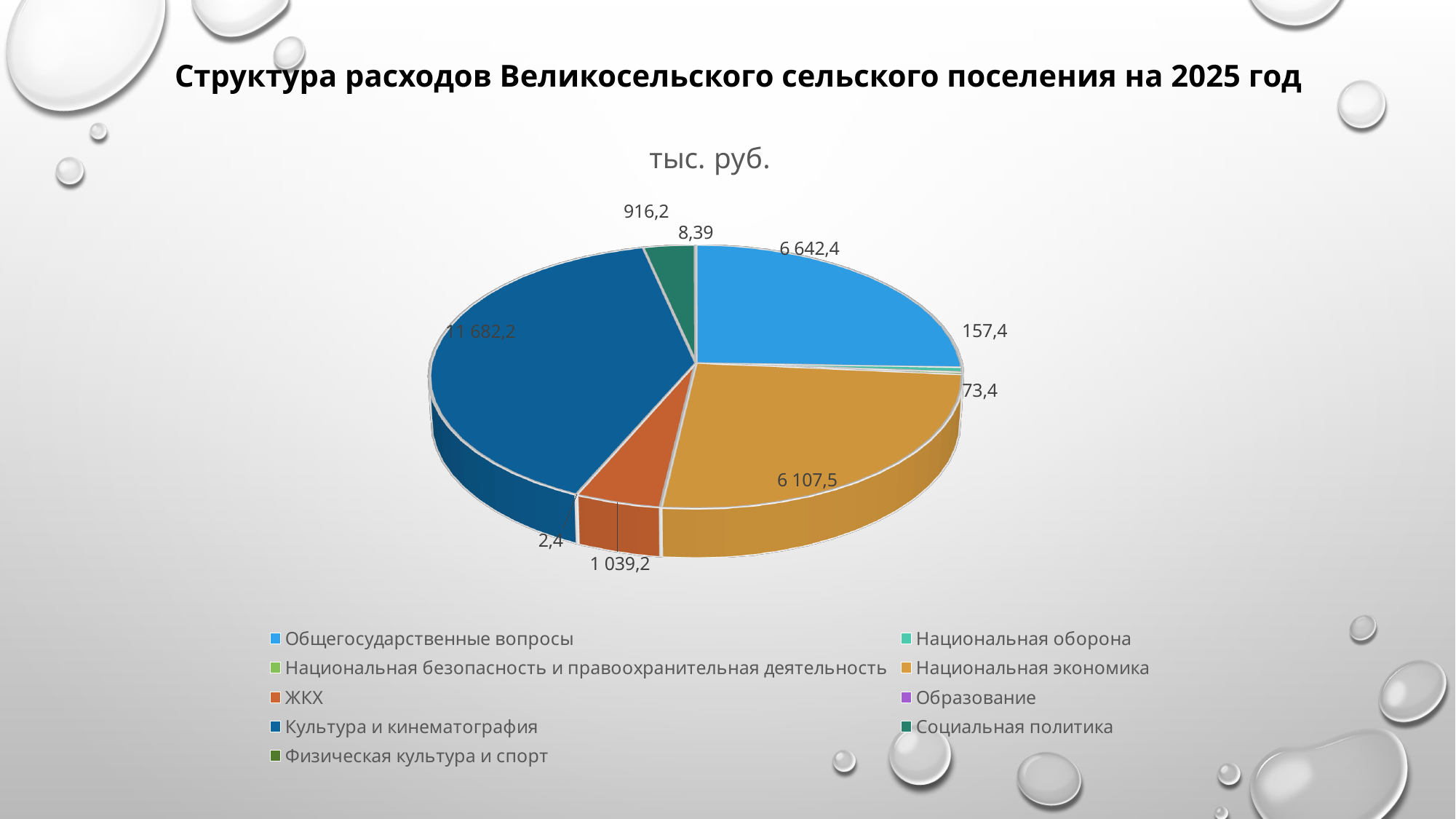
What is the value for Культура и кинематография? 11 682,2 What is the value for ЖКХ? 1 039,2 What is the value for Национальная экономика? 6 107,5 What is the value for Социальная политика? 916,2 What colour is the slice for Национальная экономика? Orange How many categories does the legend list? 9 What is the title shown above the chart? тыс. руб. Which is larger: Общегосударственные вопросы or Национальная экономика? Общегосударственные вопросы What is the difference between Общегосударственные вопросы and Национальная экономика? 534,9 What kind of chart is shown on the slide? Pie chart Which category has the largest slice of the pie? Культура и кинематография Which category has the smallest value? Образование